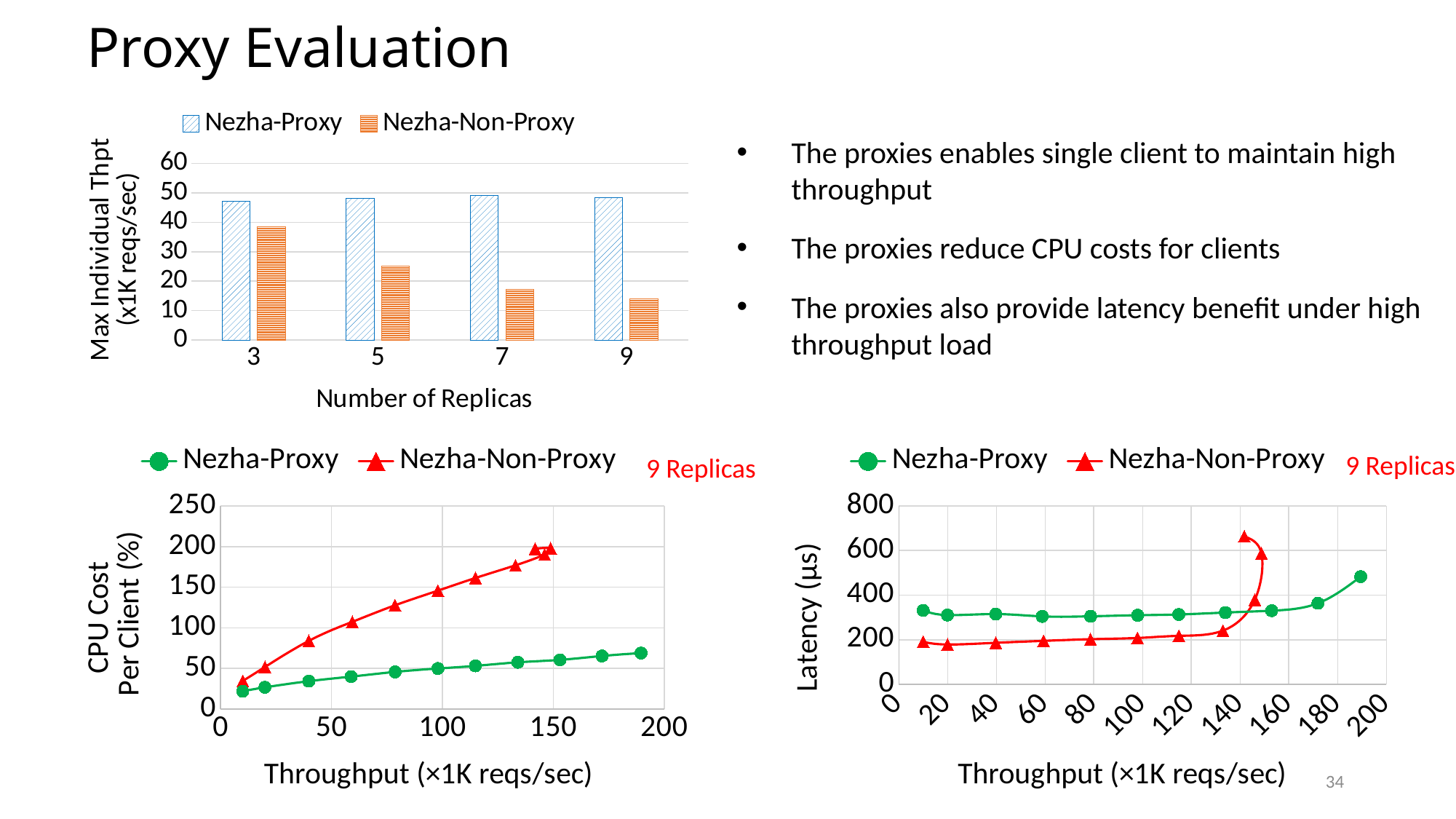
In the top-left bar chart, how many values of Number of Replicas are shown on the x axis? 4 In the top-left bar chart, is the Nezha-Non-Proxy value at 3 replicas greater or less than 30? greater In the top-left bar chart, does the Nezha-Non-Proxy value rise or fall as the number of replicas increases? fall In the bottom-left CPU Cost Per Client chart, is the highest Nezha-Proxy value greater or less than 100? less In the top-left bar chart, at which number of replicas is the Nezha-Non-Proxy value lowest? 9 In the top-left bar chart, which series has the higher value at 7 replicas? Nezha-Proxy What is the y-axis label of the bottom-right chart? Latency (µs) What kind of chart is the top-left chart showing Max Individual Thpt against Number of Replicas? bar chart In the top-left bar chart, is the Nezha-Non-Proxy value at 9 replicas greater or less than 20? less In the bottom-left CPU Cost Per Client chart, does the Nezha-Non-Proxy line rise or fall as throughput increases? rise In the bottom-left CPU Cost Per Client chart, which series has the higher CPU cost at a throughput of 100? Nezha-Non-Proxy In the top-left bar chart, how many series does the legend list? 2